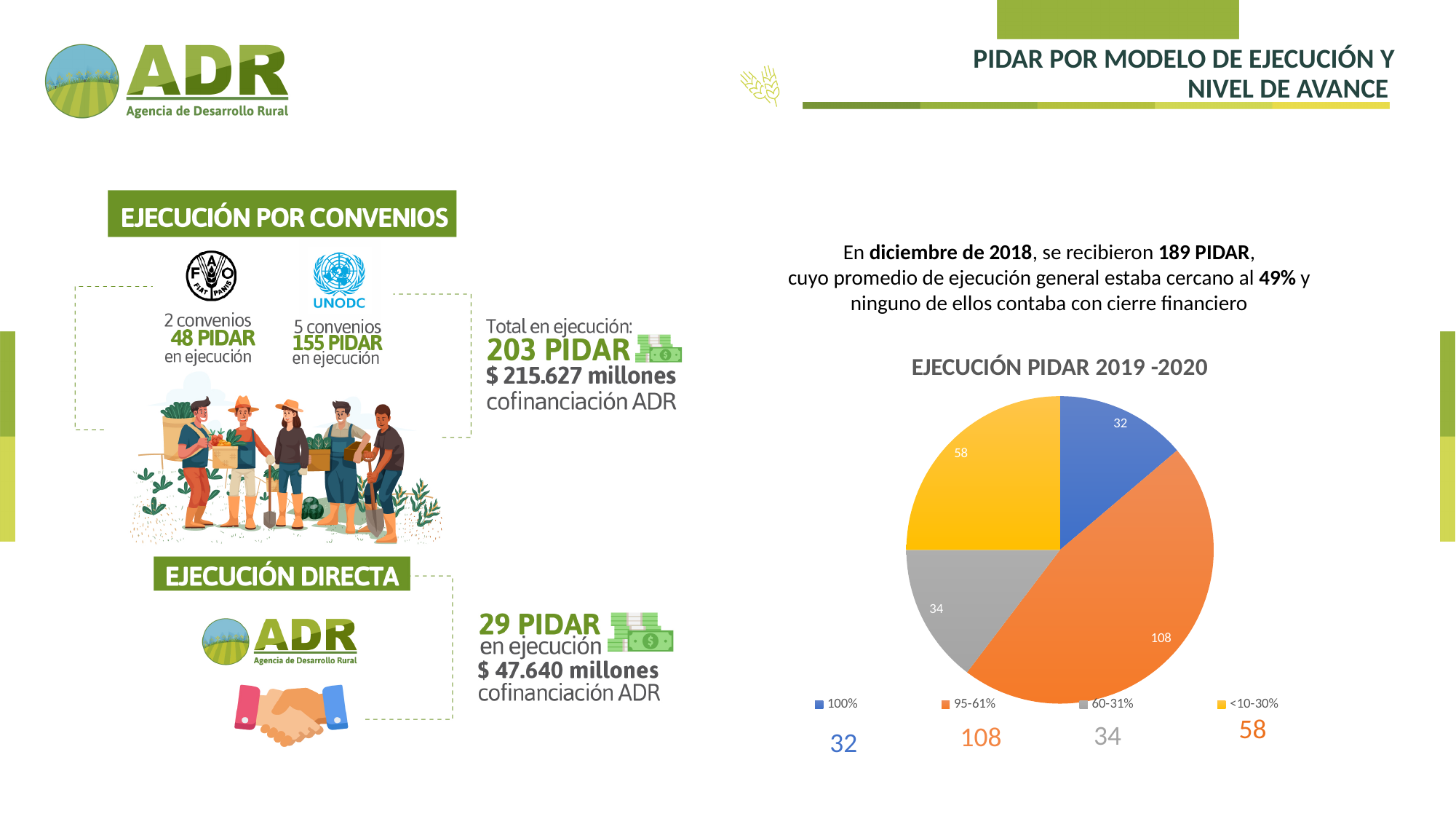
What is the value for the 95-61% category in the pie chart? 108 What is the value for the <10-30% category in the pie chart? 58 Which is larger in the pie chart, the value for 60-31% or the value for <10-30%? <10-30% How many categories does the pie chart have? 4 What type of chart is shown on the slide? pie chart What is the difference between the 95-61% value and the <10-30% value in the pie chart? 50 What is the total of all the slices in the pie chart? 232 Which category has the largest slice in the pie chart? 95-61% Which category has the smallest slice in the pie chart? 100% What is the title of the pie chart? EJECUCIÓN PIDAR 2019 -2020 What is the value for the 100% category in the pie chart? 32 What is the value for the 60-31% category in the pie chart? 34